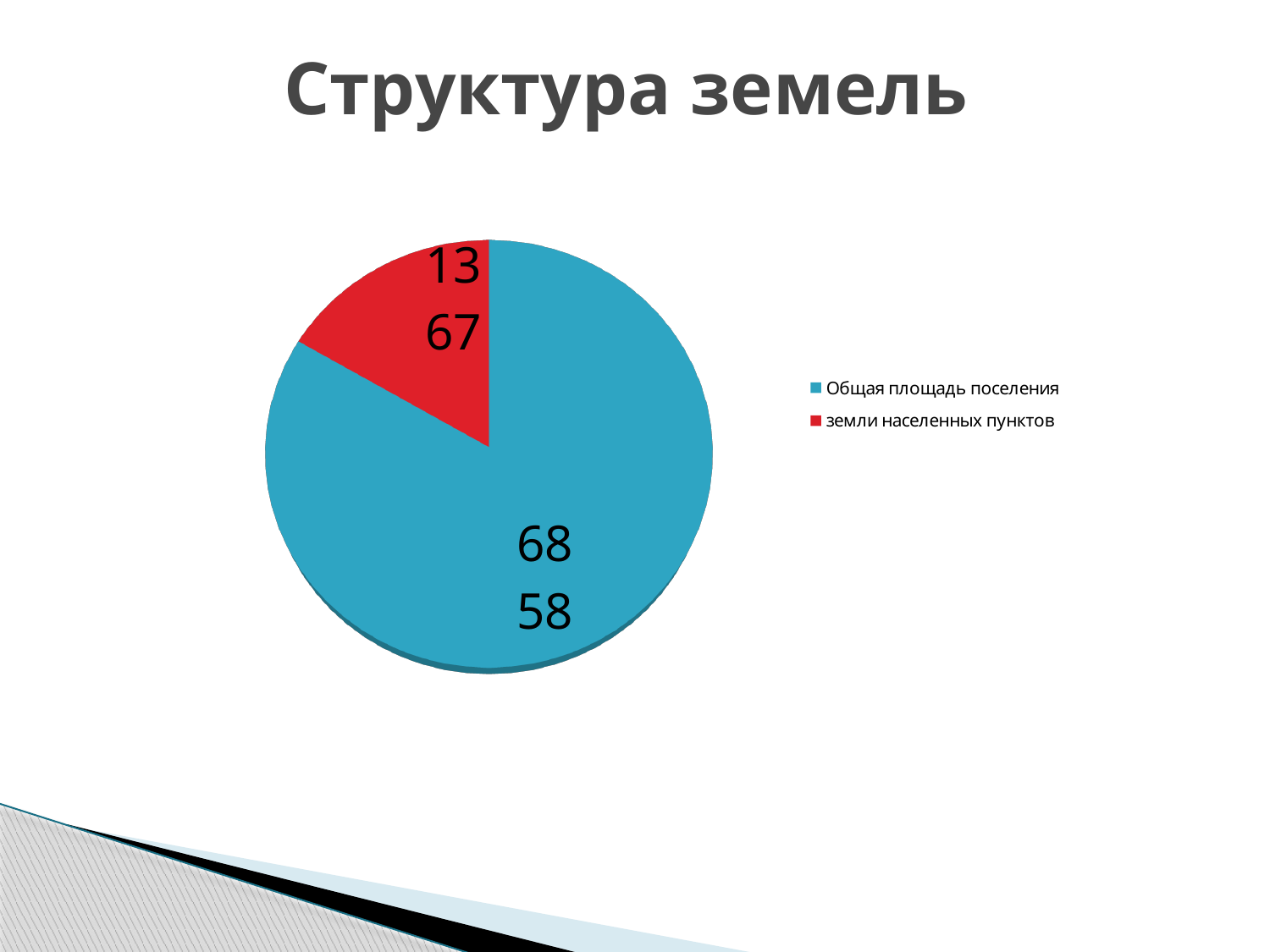
What value is labelled on the slice for земли населенных пунктов? 1367 How many entries does the legend list? 2 What is the title of the chart? Структура земель What is the difference between the values for Общая площадь поселения and земли населенных пунктов? 5491 What colour is the slice for земли населенных пунктов? red What is the total of the two values shown on the pie chart? 8225 What kind of chart is shown on the slide? pie chart How many slices does the pie chart have? 2 Which is larger: Общая площадь поселения or земли населенных пунктов? Общая площадь поселения Which category has the largest slice of the pie? Общая площадь поселения What value is labelled on the slice for Общая площадь поселения? 6858 Which category has the smallest slice of the pie? земли населенных пунктов